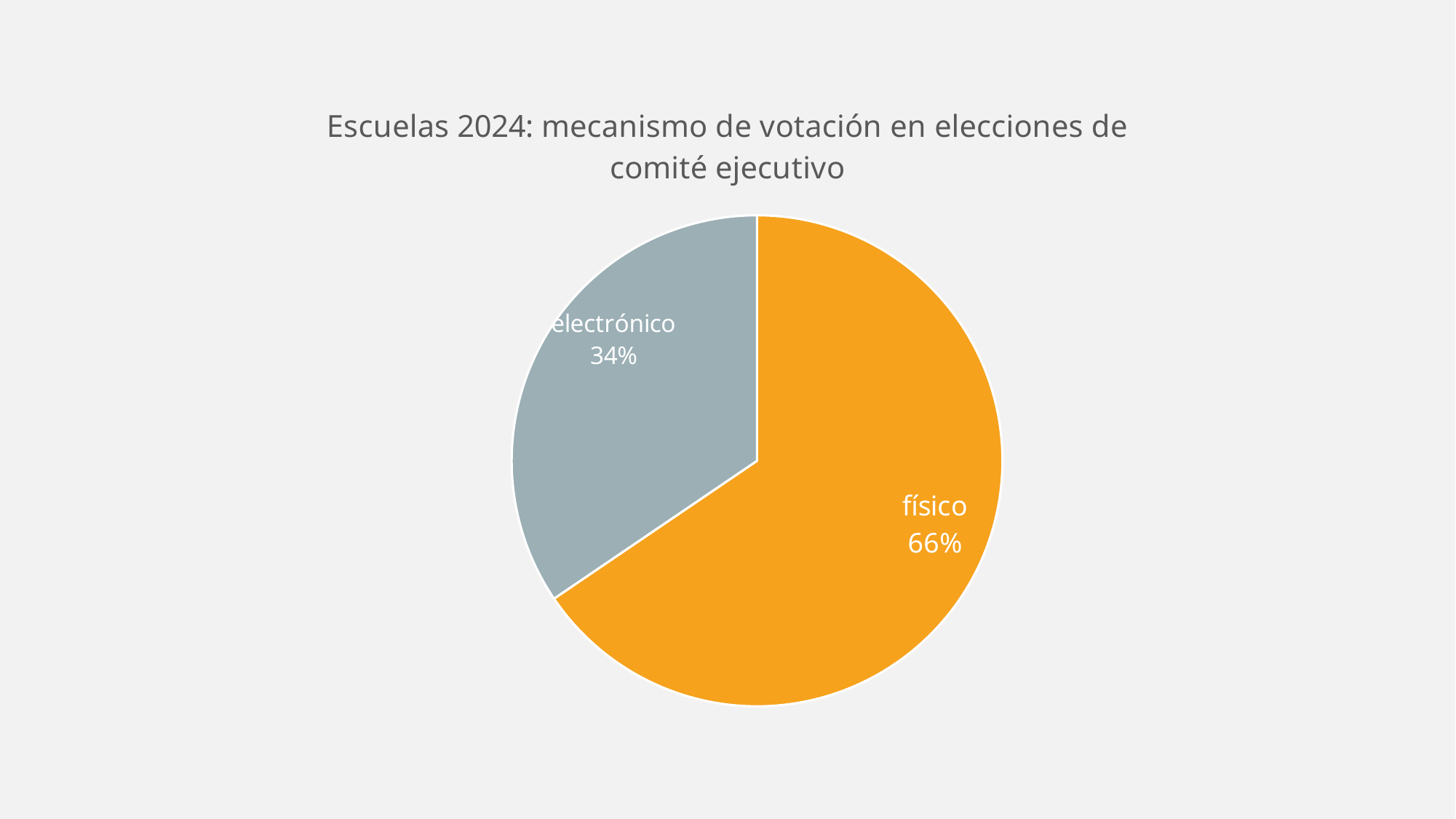
Which category has the largest slice of the pie? físico Which is larger, the 'físico' slice or the 'electrónico' slice? físico What is the title of the chart? Escuelas 2024: mecanismo de votación en elecciones de comité ejecutivo What share of the pie does the 'electrónico' slice represent? 34% How many categories are shown in the pie chart? 2 What colour is the 'físico' slice? orange What share of the pie does the 'físico' slice represent? 66% What kind of chart is shown on the slide? pie chart What is the difference in percentage points between the 'físico' and 'electrónico' slices? 32 Is the share for 'electrónico' greater or less than 50%? less Which category has the smallest slice of the pie? electrónico